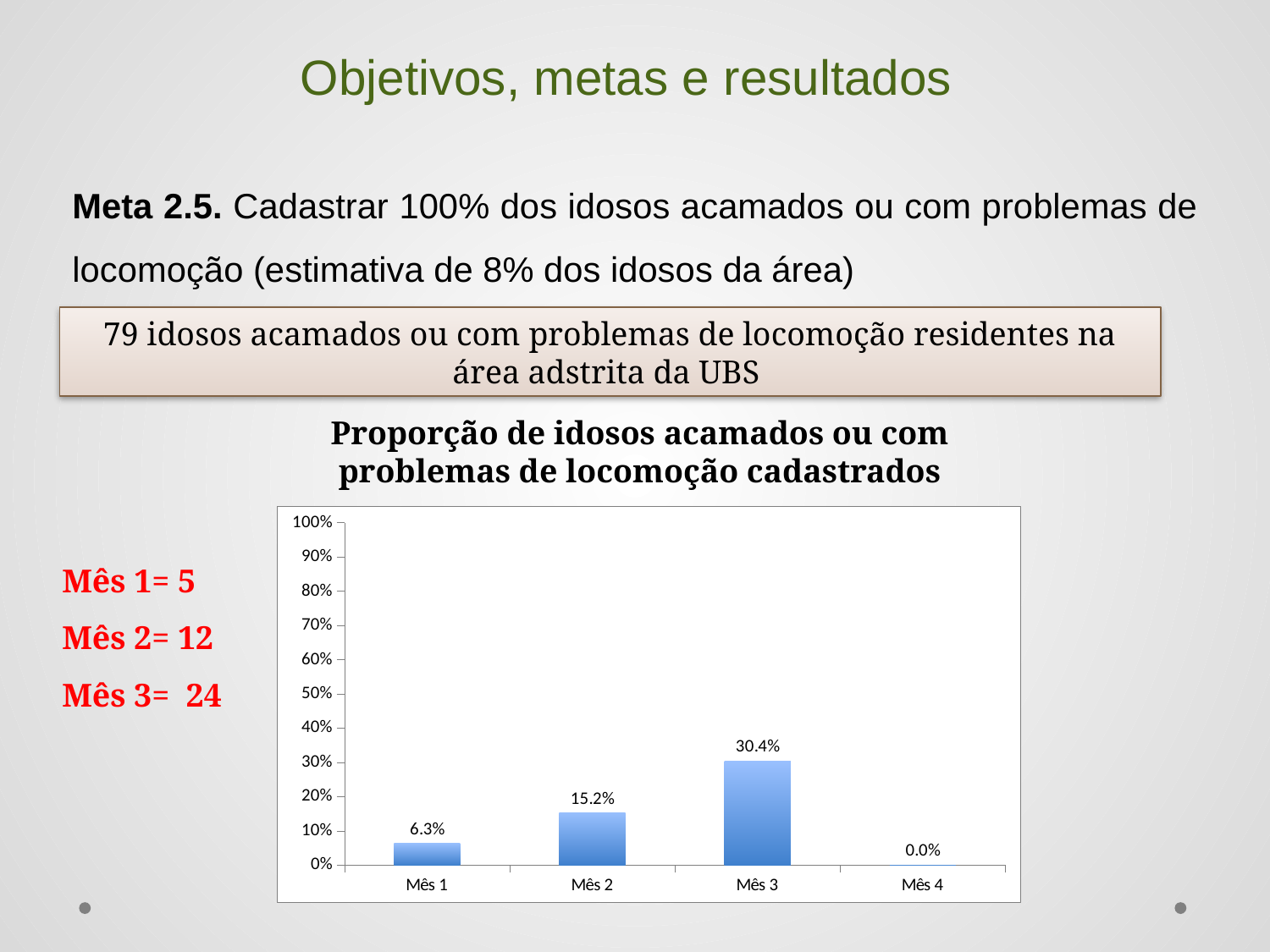
What is the value for Mês 1? 6.3% What is the value for Mês 3? 30.4% Which month has the highest value? Mês 3 What is the difference between the values for Mês 3 and Mês 2? 15.2% Is the value for Mês 3 greater or less than 40%? less What is the value for Mês 4? 0.0% What kind of chart is shown? bar chart Which month has the lowest value? Mês 4 How many months are shown on the x axis? 4 What is the value for Mês 2? 15.2% What is the title of the chart? Proporção de idosos acamados ou com problemas de locomoção cadastrados Which is larger, the value for Mês 1 or the value for Mês 2? Mês 2